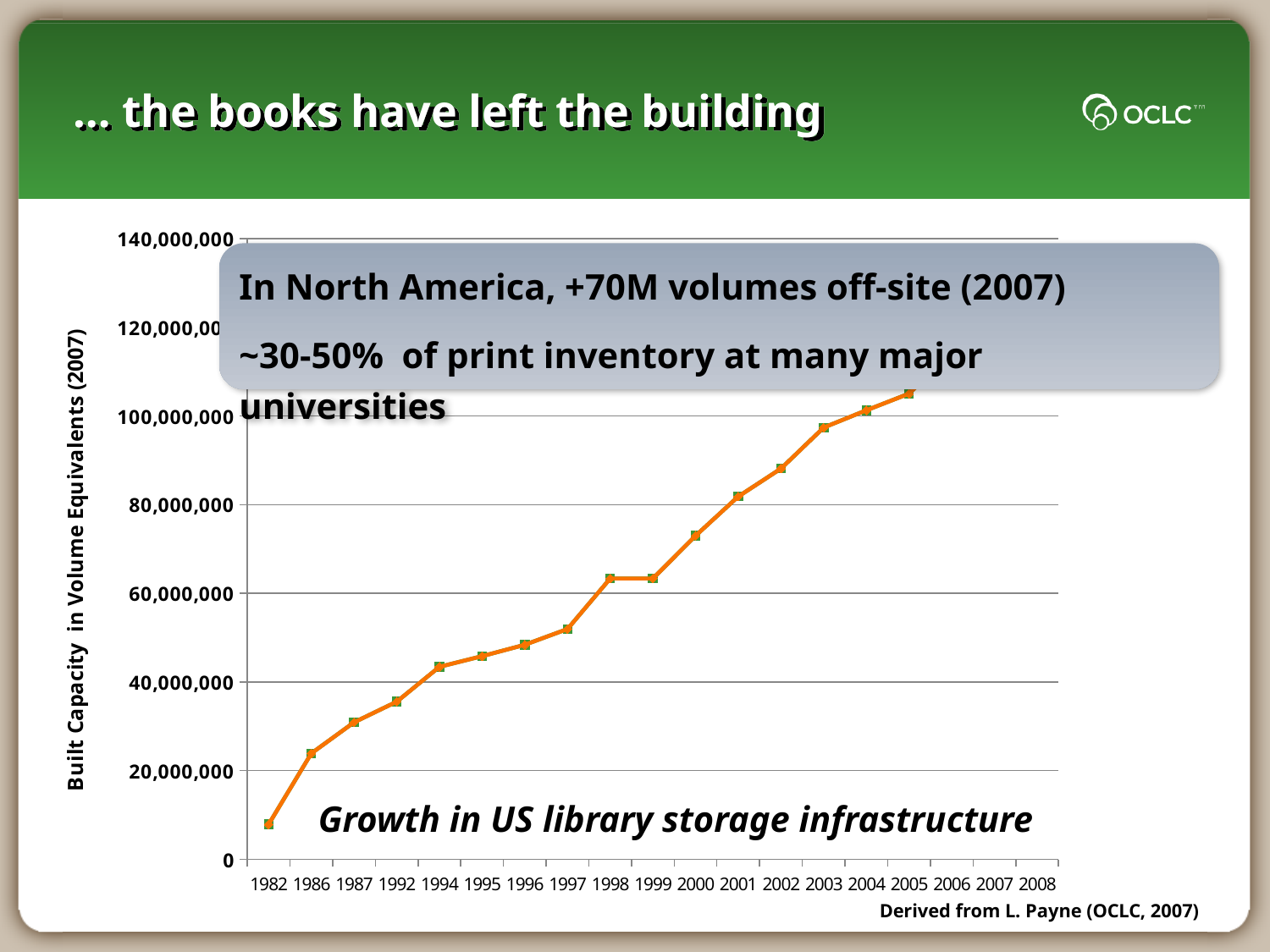
Is the value for 1986 greater or less than 20,000,000? greater What kind of chart is shown on the slide? line chart Is the value for 1992 greater or less than 40,000,000? less Which year has the lowest built capacity in the chart? 1982 Is the value for 1998 greater or less than 60,000,000? greater What is the label of the y axis? Built Capacity in Volume Equivalents (2007) How many year labels are shown on the x axis? 19 What is the title printed inside the chart area? Growth in US library storage infrastructure Does built capacity rise or fall over the years shown on the x axis? rise Which year has the larger built capacity, 1997 or 2002? 2002